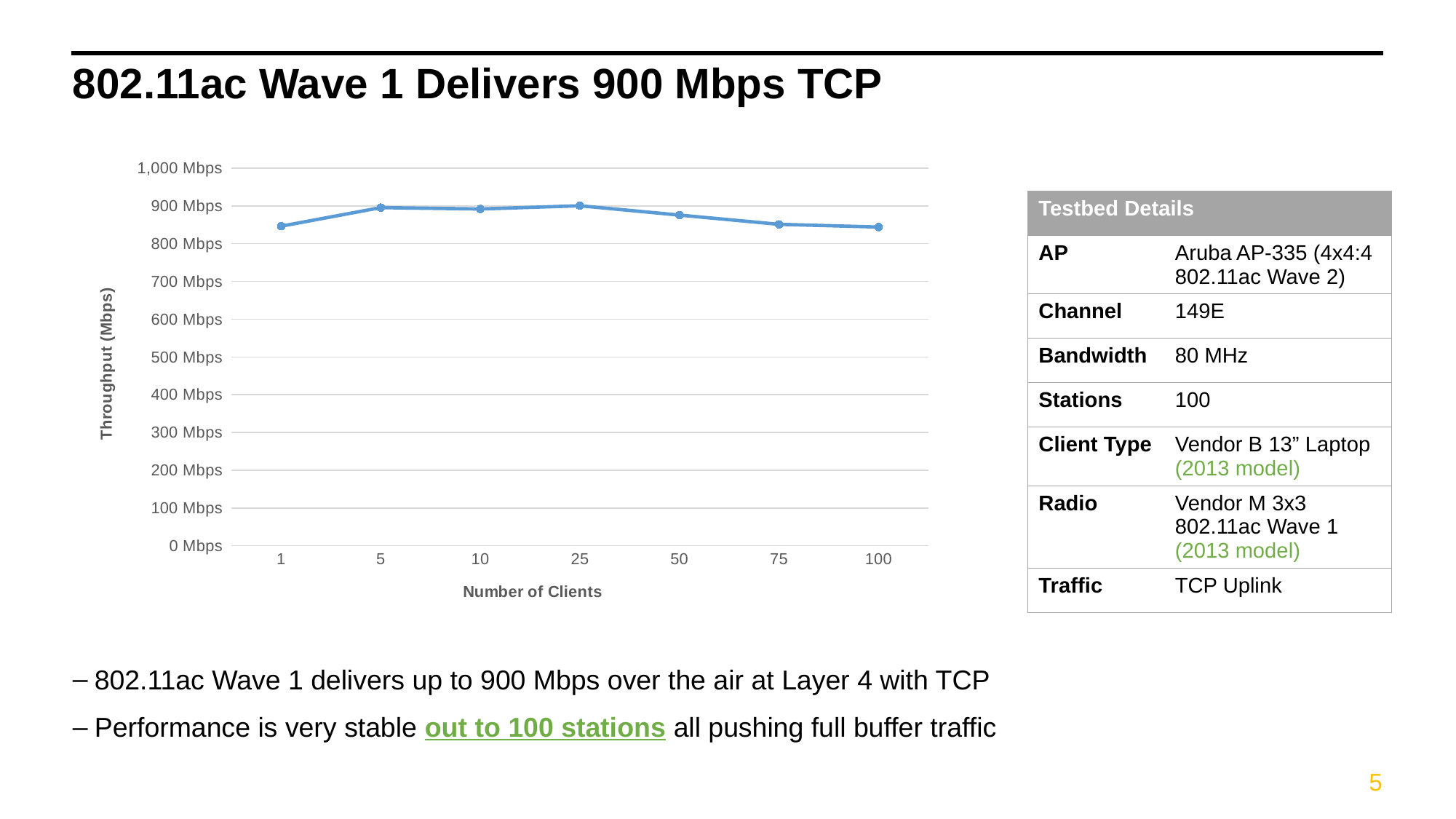
What is the label of the x axis? Number of Clients What is the label of the y axis? Throughput (Mbps) Is the throughput for 100 clients greater or less than 900 Mbps? less Is the throughput for 75 clients greater or less than 700 Mbps? greater Which has higher throughput: 25 clients or 100 clients? 25 clients Which has higher throughput: 5 clients or 75 clients? 5 clients How many data points are plotted on the line chart? 7 Does throughput rise or fall from 25 clients to 100 clients? fall Is the throughput for 1 client greater or less than 800 Mbps? greater What kind of chart is shown on the slide? line chart